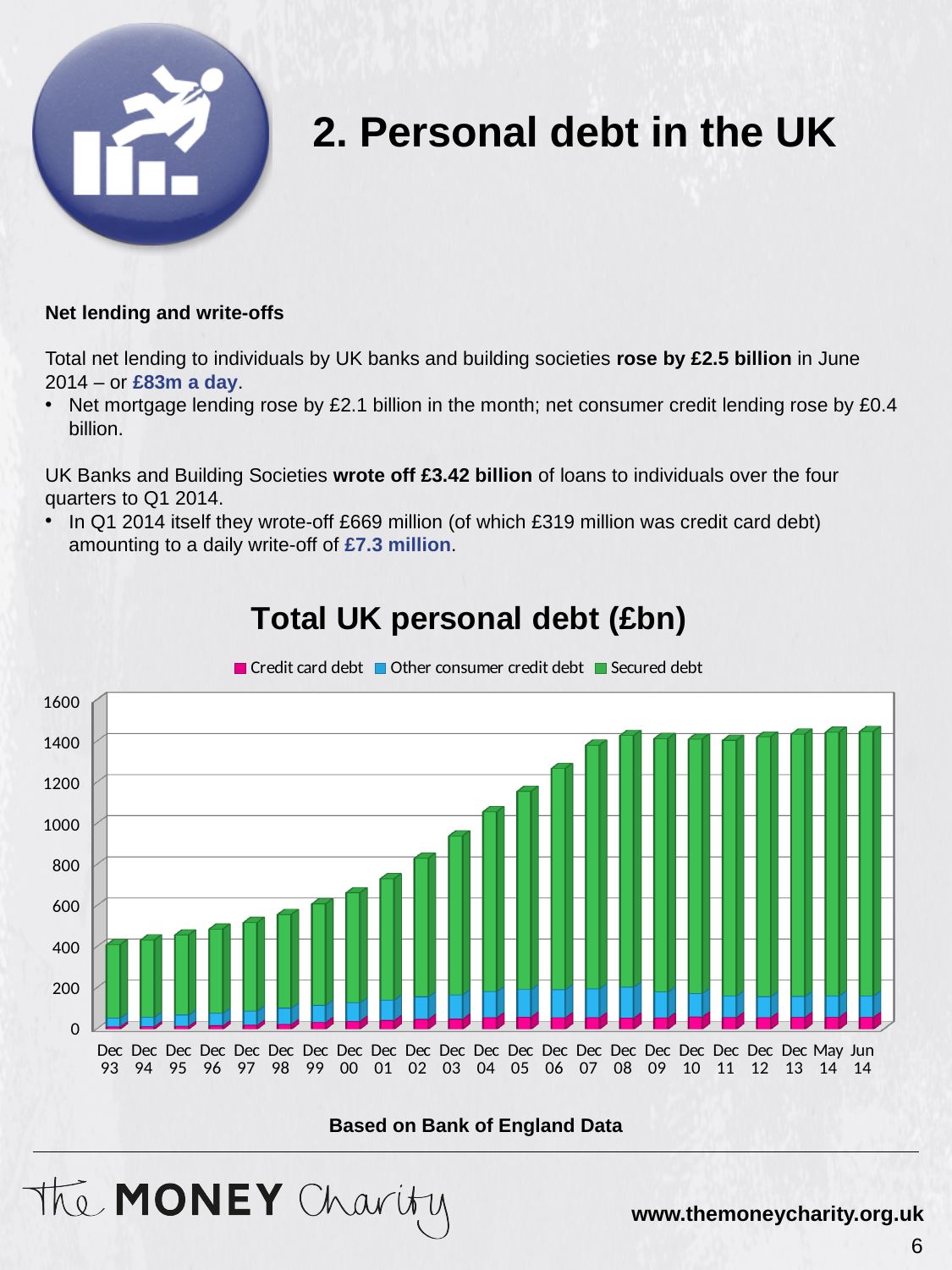
Which has the larger total personal debt, Dec 03 or Dec 06? Dec 06 How many time points are plotted along the x axis of the "Total UK personal debt (£bn)" chart? 23 How many series does the legend of the "Total UK personal debt (£bn)" chart list? 3 What is the first series listed in the legend of the "Total UK personal debt (£bn)" chart? Credit card debt Is the total personal debt for Jun 14 greater or less than 1400? greater What kind of chart is shown under the title "Total UK personal debt (£bn)"? Stacked bar chart Which time point has the lowest total personal debt in the chart? Dec 93 Overall, does total UK personal debt rise or fall from Dec 93 to Jun 14? Rise Is the total personal debt for Dec 03 greater or less than 800? greater Which series in the "Total UK personal debt (£bn)" chart is shown in green? Secured debt Is the total personal debt for Dec 96 greater or less than 600? less